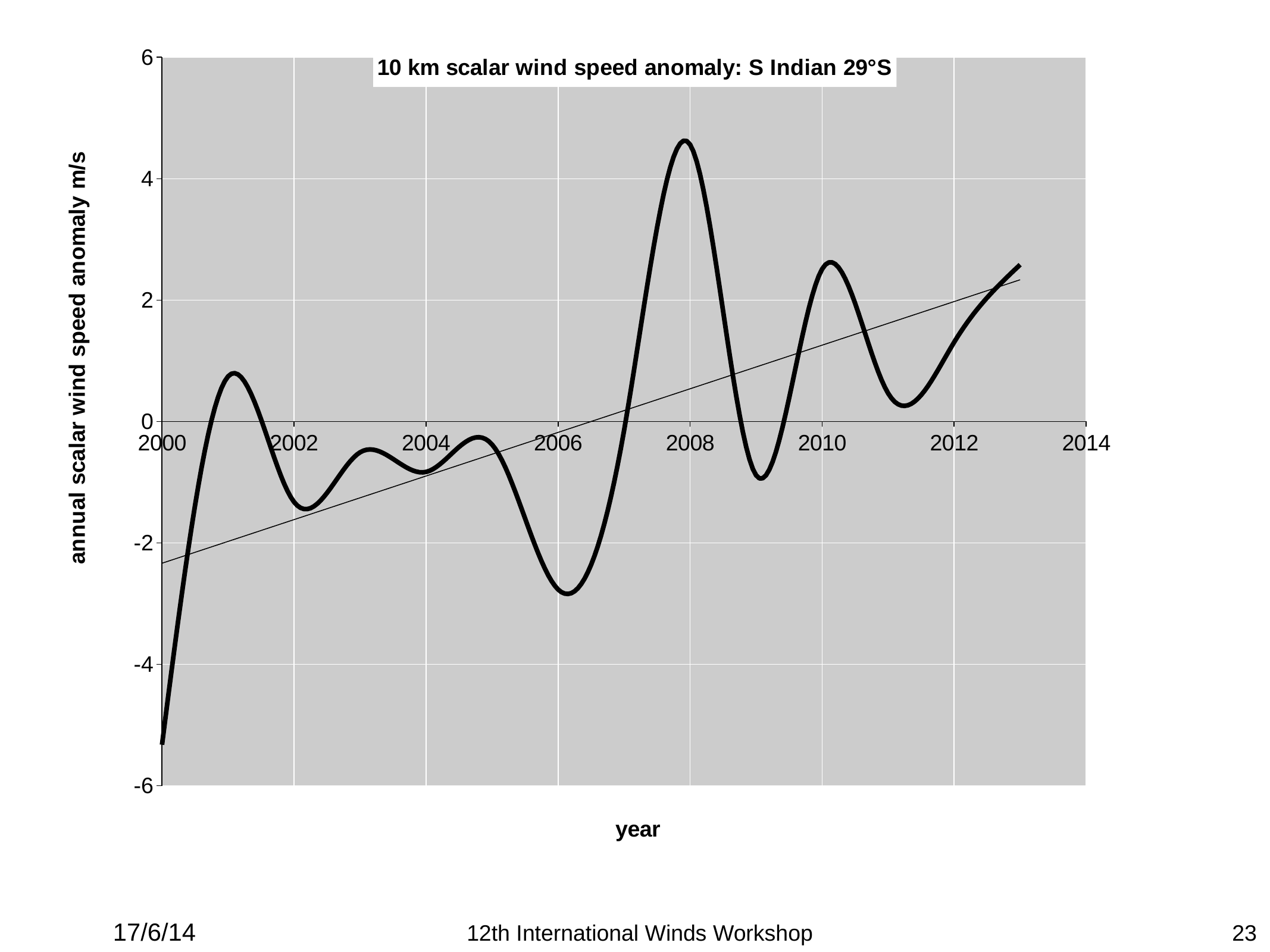
Is the value of the anomaly curve at 2010 greater or less than 2? greater What is the title of the chart? 10 km scalar wind speed anomaly: S Indian 29°S Is the value of the anomaly curve at 2008 greater or less than 4? greater Which year has the larger anomaly value on the curve, 2008 or 2010? 2008 Is the value of the anomaly curve at 2006 greater or less than -2? less What is the label of the vertical axis? annual scalar wind speed anomaly m/s In which year does the wind speed anomaly curve reach its highest peak? 2008 In which year does the wind speed anomaly curve reach its lowest value? 2000 Which year has the larger anomaly value on the curve, 2004 or 2006? 2004 Does the thin straight trend line rise or fall from 2000 to 2014? rise What kind of chart is shown on the slide? line chart